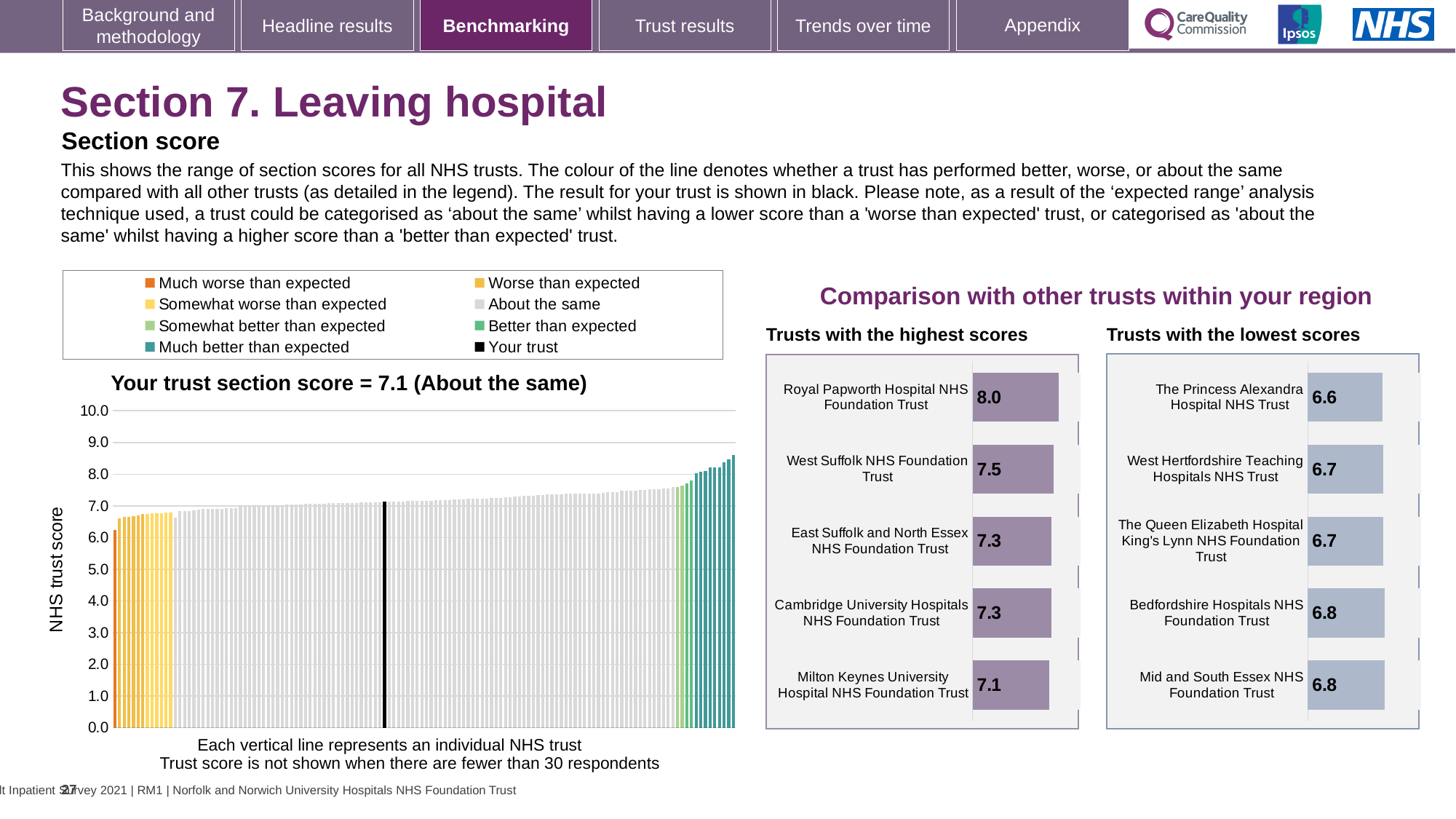
In the 'Trusts with the highest scores' chart, what is the difference between the scores of Royal Papworth Hospital NHS Foundation Trust and West Suffolk NHS Foundation Trust? 0.5 In the 'Trusts with the lowest scores' chart, which trust has the lowest score? The Princess Alexandra Hospital NHS Trust In the 'Trusts with the highest scores' chart, what is the score for West Suffolk NHS Foundation Trust? 7.5 In the 'Trusts with the lowest scores' chart, what is the score for Bedfordshire Hospitals NHS Foundation Trust? 6.8 In the 'Trusts with the highest scores' chart, what is the score for Royal Papworth Hospital NHS Foundation Trust? 8.0 In the 'Trusts with the lowest scores' chart, what is the score for The Princess Alexandra Hospital NHS Trust? 6.6 In the 'Your trust section score' chart on the left, is the value of the tallest bar greater or less than 8.0? greater In the 'Trusts with the lowest scores' chart, how many trusts are shown? 5 What kind of chart is the 'Your trust section score' chart on the left? bar chart In the 'Your trust section score' chart on the left, what is the section score for your trust? 7.1 In the 'Trusts with the highest scores' chart, which trust has the highest score? Royal Papworth Hospital NHS Foundation Trust How many entries does the legend above the 'Your trust section score' chart list? 8